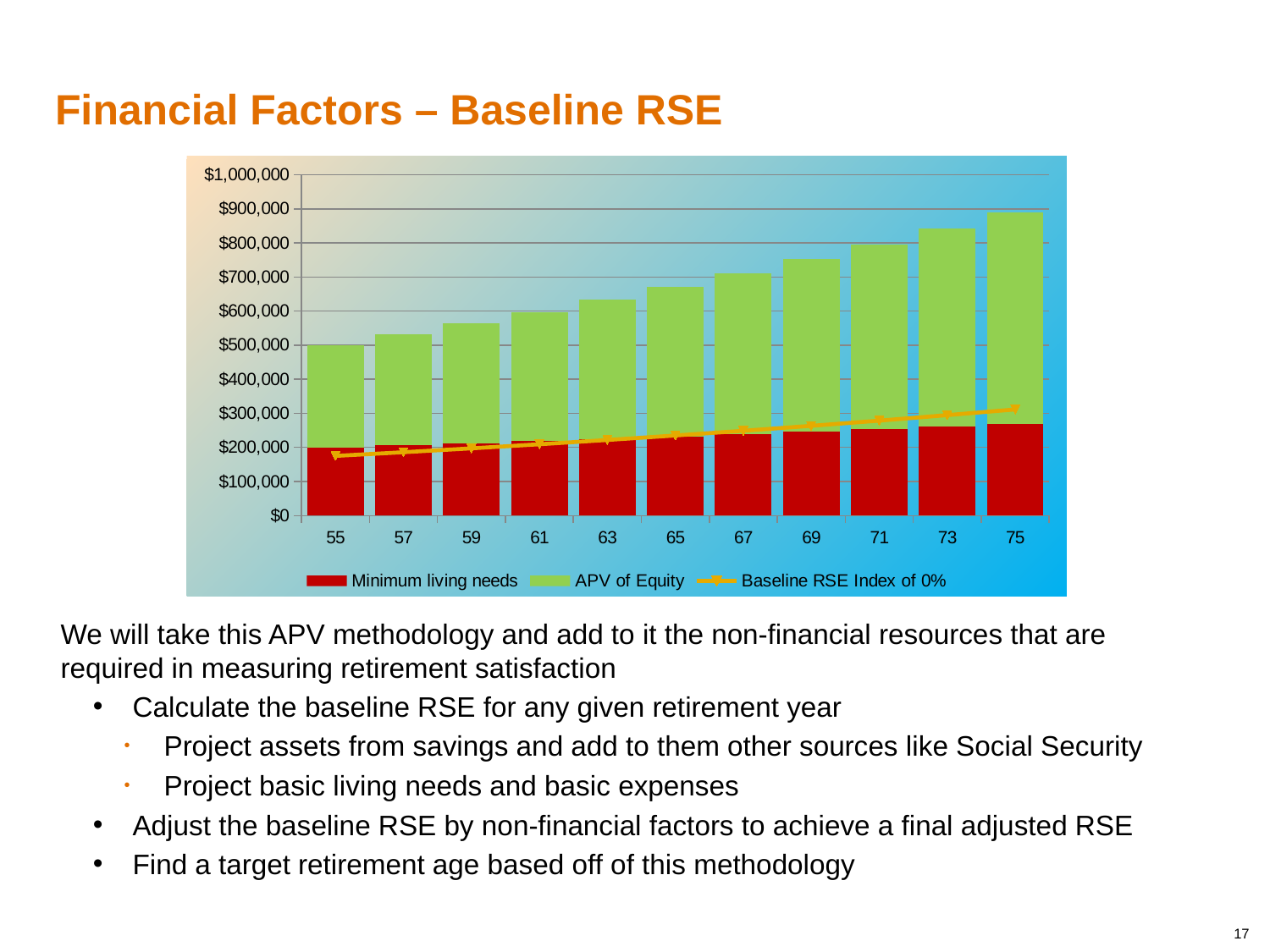
Which age has the shortest stacked bar? 55 Does the Baseline RSE Index of 0% line rise or fall from age 55 to age 75? rise How many age categories are shown on the x axis? 11 Which series is plotted as a line rather than bars? Baseline RSE Index of 0% Is the total stacked bar value for age 75 greater or less than $800,000? greater Which series is shown in red in the legend? Minimum living needs Is the Minimum living needs value for age 75 greater or less than $300,000? less What kind of chart is shown on the slide? combination stacked bar and line chart How many series does the legend list? 3 Which age has the tallest stacked bar? 75 Do the stacked bar totals rise or fall as age increases from 55 to 75? rise Is the total stacked bar value for age 65 greater or less than $600,000? greater